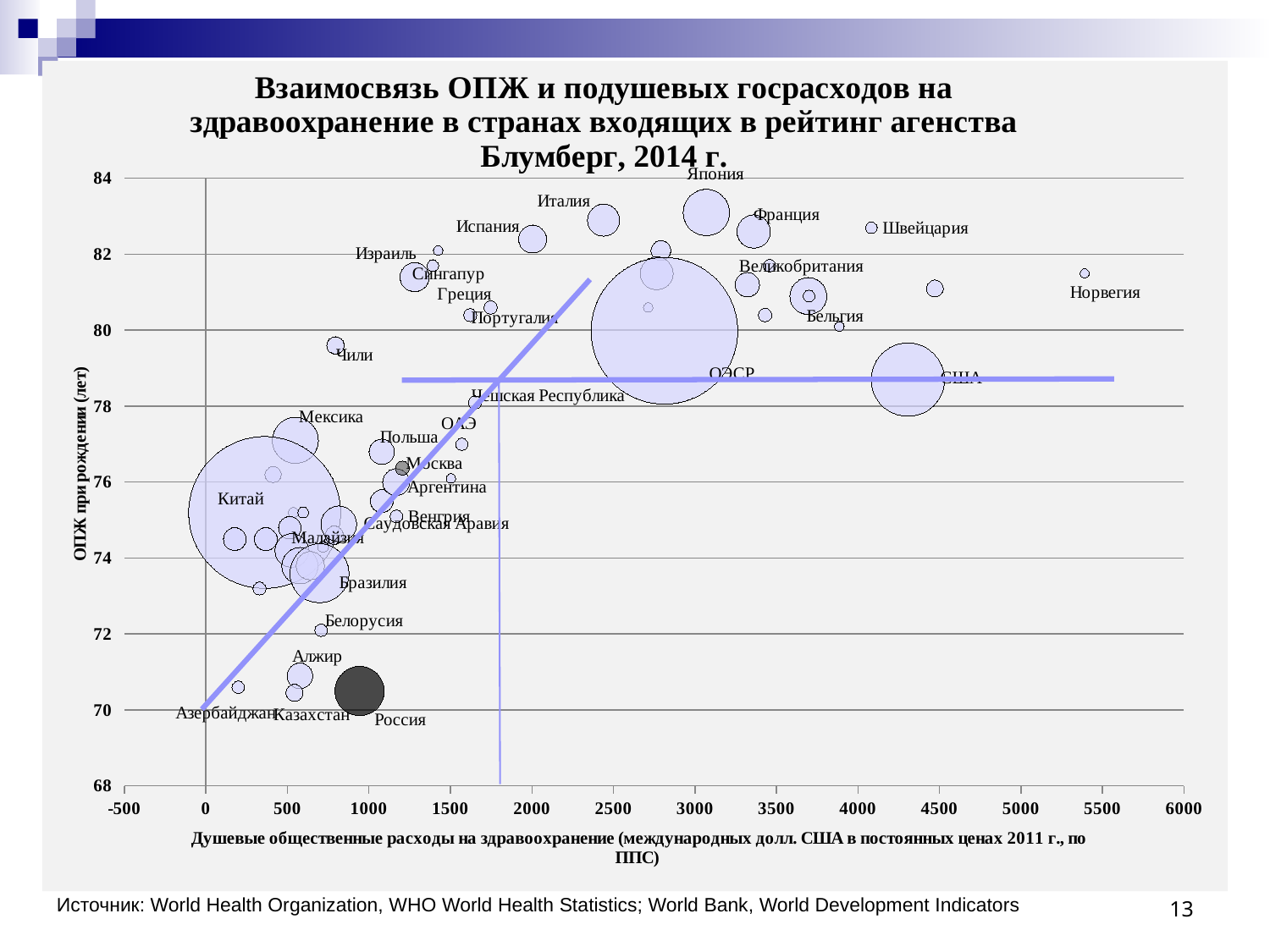
Which country has the highest per capita public health spending on the chart? Норвегия Is the per capita public health spending for Китай greater or less than 500? less Which has the higher per capita public health spending, США or Китай? США Is the life expectancy at birth for Япония greater or less than 82? greater What is the label of the vertical axis of the chart? ОПЖ при рождении (лет) Which country has the highest life expectancy at birth on the chart? Япония What kind of chart is shown on the slide? Bubble chart Which has the higher life expectancy at birth, Япония or Россия? Япония What is the title of the chart? Взаимосвязь ОПЖ и подушевых госрасходов на здравоохранение в странах входящих в рейтинг агенства Блумберг, 2014 г. Is the per capita public health spending for Норвегия greater or less than 5000? greater